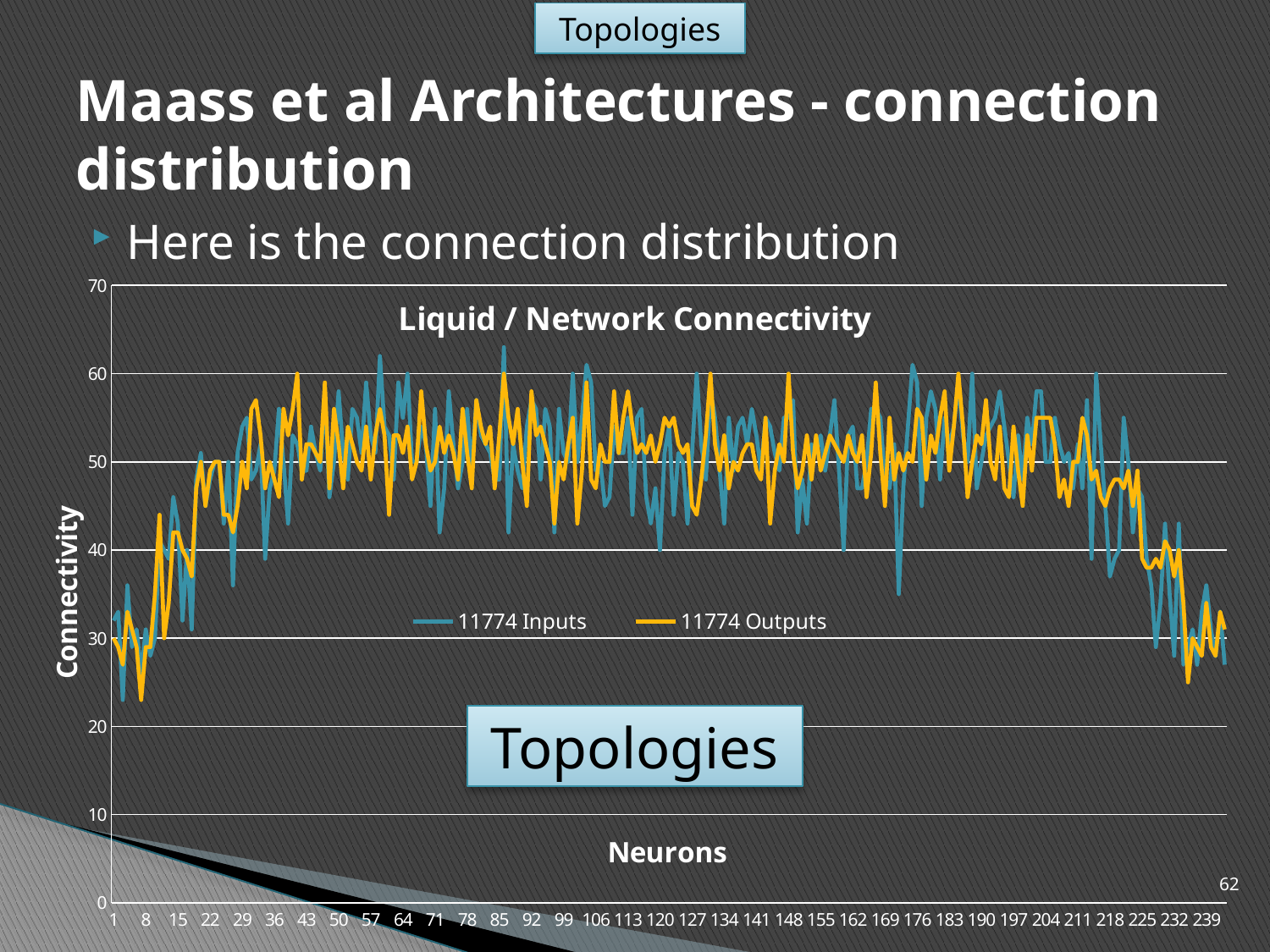
Is the value for 11774 Outputs at neuron 1 greater or less than 40? less What is the title of the chart? Liquid / Network Connectivity What are the two series named in the chart legend? 11774 Inputs and 11774 Outputs What kind of chart is shown on the slide? line chart What is the highest tick value shown on the vertical axis? 70 What is the label of the horizontal axis of the chart? Neurons How many series does the chart legend list? 2 Do the values of 11774 Outputs rise or fall between neuron 1 and neuron 29? rise What is the last label shown on the horizontal axis? 239 What is the label of the vertical axis of the chart? Connectivity Is the value for 11774 Inputs at neuron 239 greater or less than 40? less